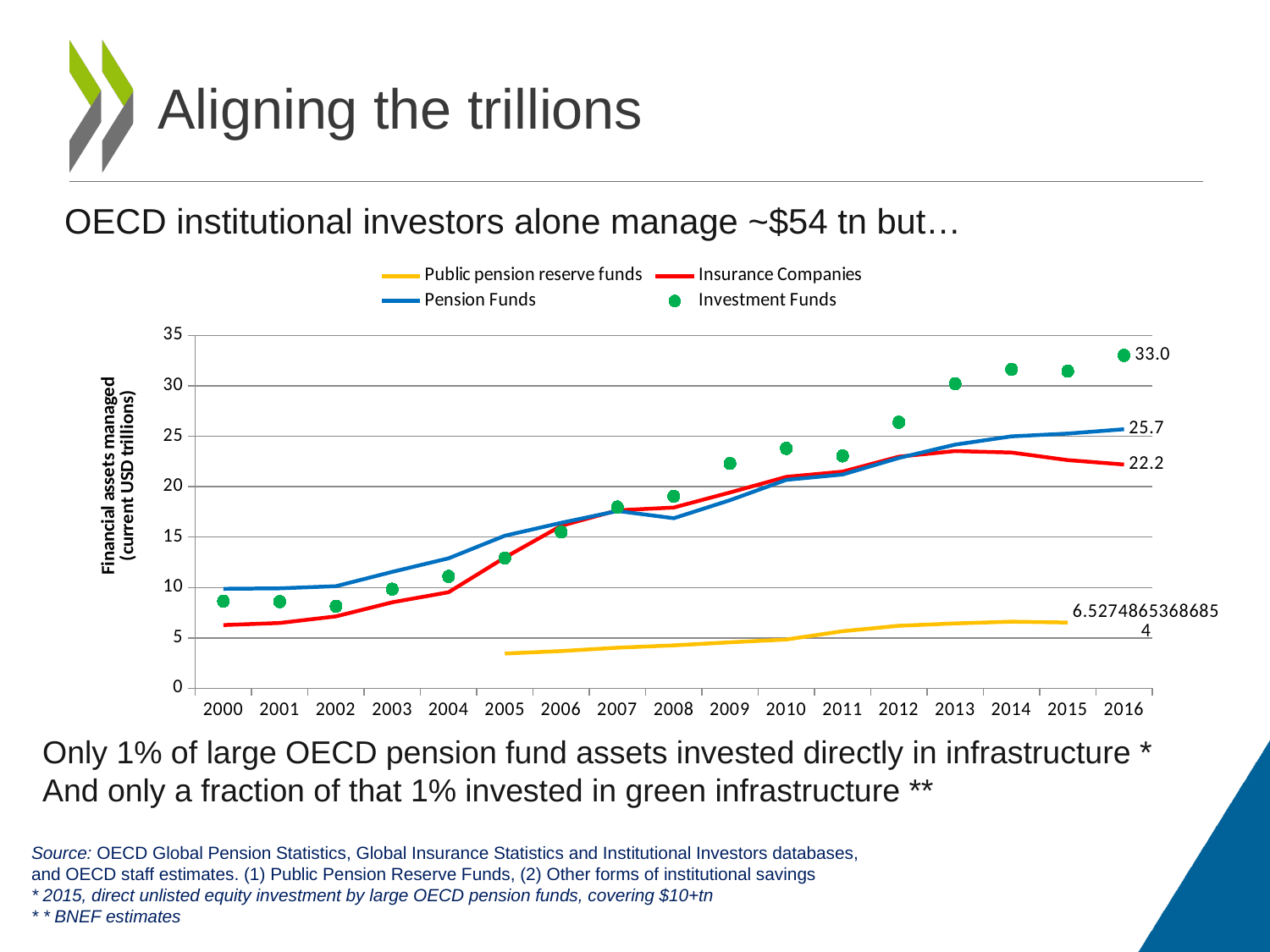
Which series has the highest value in 2016? Investment Funds Do the values for Investment Funds generally rise or fall from 2000 to 2016? rise What is the value for Pension Funds in 2016? 25.7 What is the difference between the 2016 values for Investment Funds and Pension Funds? 7.3 What kind of chart is shown on the slide? line chart In 2016, which is larger: Pension Funds or Insurance Companies? Pension Funds Which series is plotted as green dots rather than a line? Investment Funds Is the value for Public pension reserve funds in 2015 greater or less than 10? less How many series does the chart legend list? 4 What is the difference between the 2016 values for Pension Funds and Insurance Companies? 3.5 What is the value for Investment Funds in 2016? 33.0 What is the value for Insurance Companies in 2016? 22.2